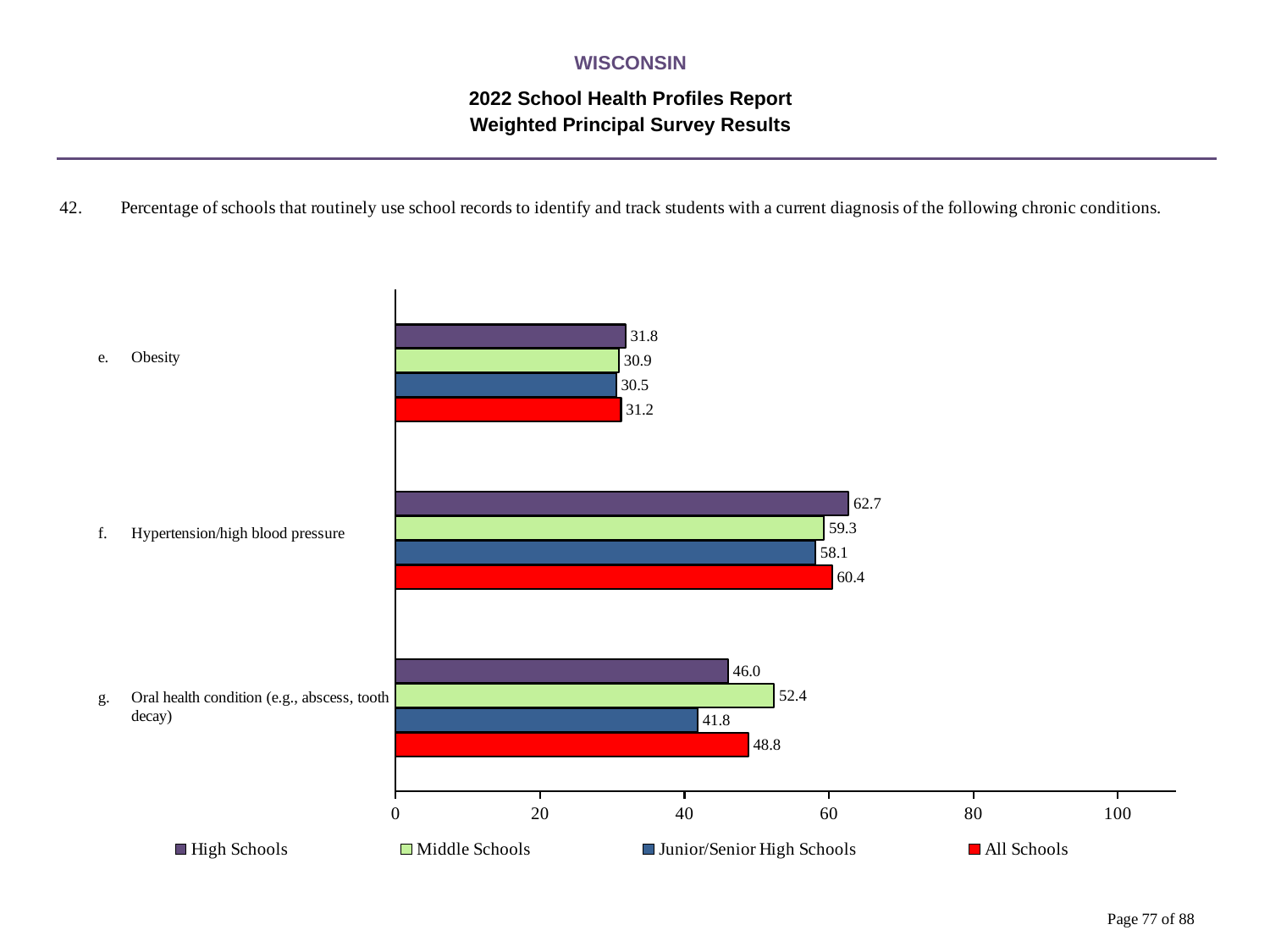
Is the value for All Schools for Hypertension/high blood pressure greater or less than 60? greater What is the difference between the High Schools and Junior/Senior High Schools values for Hypertension/high blood pressure? 4.6 Which chronic condition has the lowest value for High Schools? Obesity Which chronic condition has the highest value for All Schools? Hypertension/high blood pressure What is the value for Junior/Senior High Schools for Obesity? 30.5 What is the value for Middle Schools for Oral health condition? 52.4 What kind of chart is shown on the slide? Bar chart What is the value for All Schools for Oral health condition? 48.8 How many chronic conditions are shown on the chart? 3 What is the value for High Schools for Hypertension/high blood pressure? 62.7 How many series does the legend list? 4 For Oral health condition, which is larger: the Middle Schools value or the High Schools value? Middle Schools